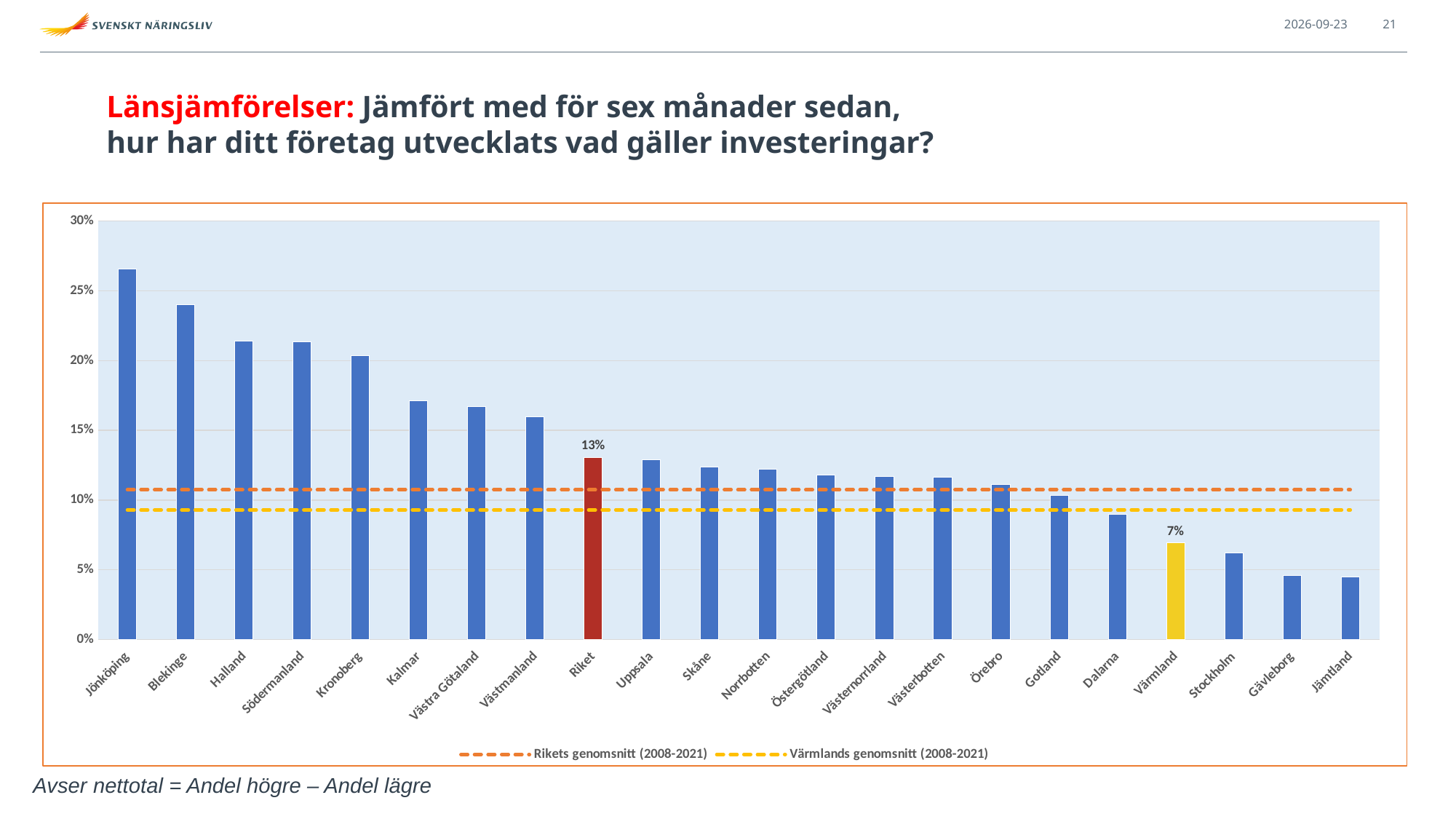
Which county has the highest bar in the chart? Jönköping Is the value for Stockholm greater or less than 10%? less How many bars (categories) are shown in the chart? 22 How many entries does the legend list? 2 Is the value for Jönköping greater or less than 25%? greater What is the value shown for Riket? 13% Is the value for Halland greater or less than 20%? greater What kind of chart is shown on the slide? Bar chart Do the bar values rise or fall from left to right along the x axis? Fall What is the value shown for Värmland? 7% Which is larger, the value for Riket or the value for Värmland? Riket What is the difference between the values for Riket and Värmland? 6 percentage points